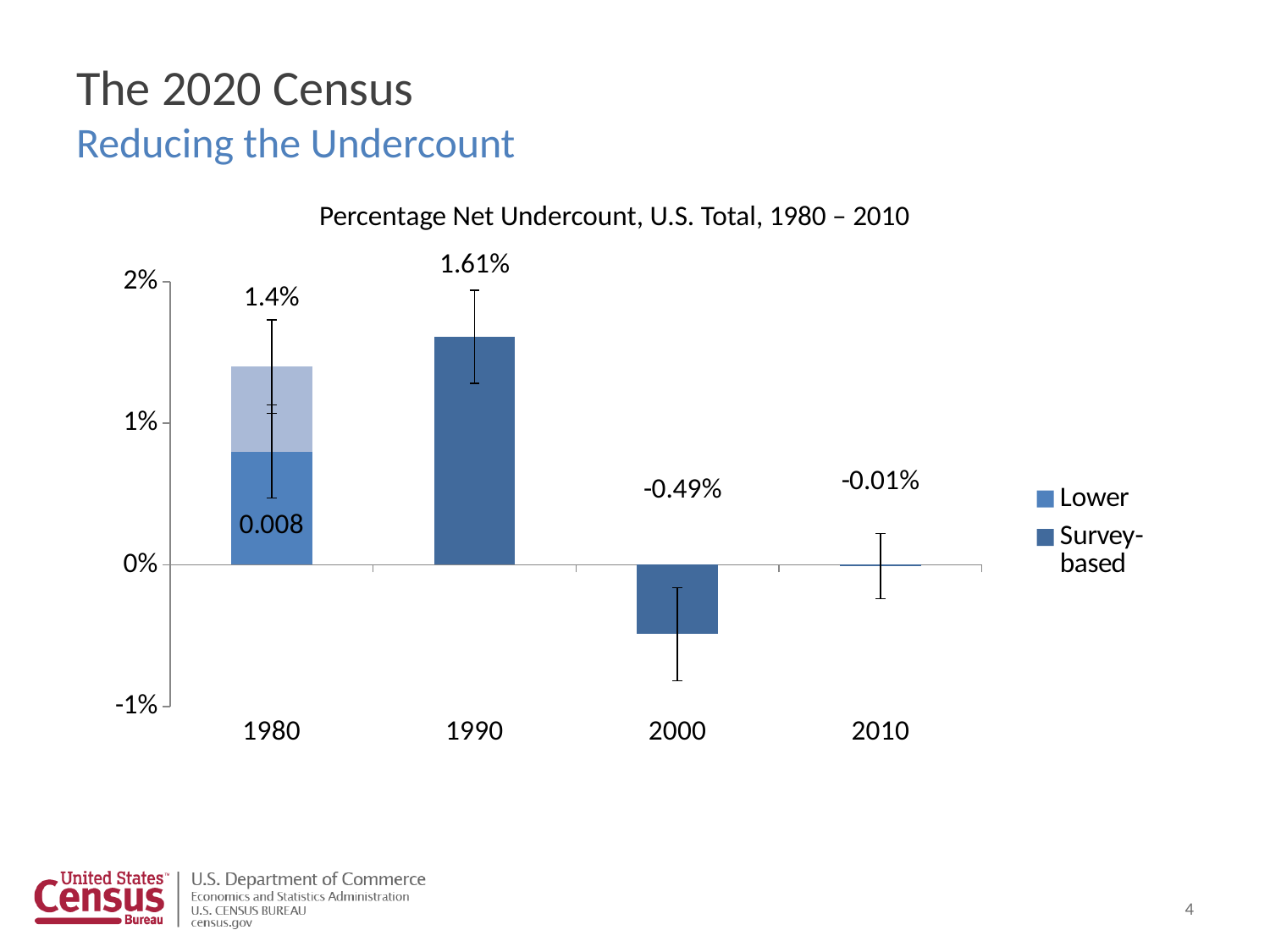
What value is labelled on the 1980 bar as a whole? 1.4% What is the percentage net undercount shown for 1990? 1.61% What kind of chart is shown on the slide? bar chart How many series does the legend list? 2 What is the difference between the net undercount for 1990 and for 1980? 0.21% Is the value for 2000 greater or less than 0%? less Which year has the lowest percentage net undercount? 2000 Which year has the highest percentage net undercount? 1990 Which year has the larger net undercount, 1980 or 1990? 1990 How many years are shown on the x axis? 4 What is the percentage net undercount shown for 2000? -0.49% What is the percentage net undercount shown for 2010? -0.01%